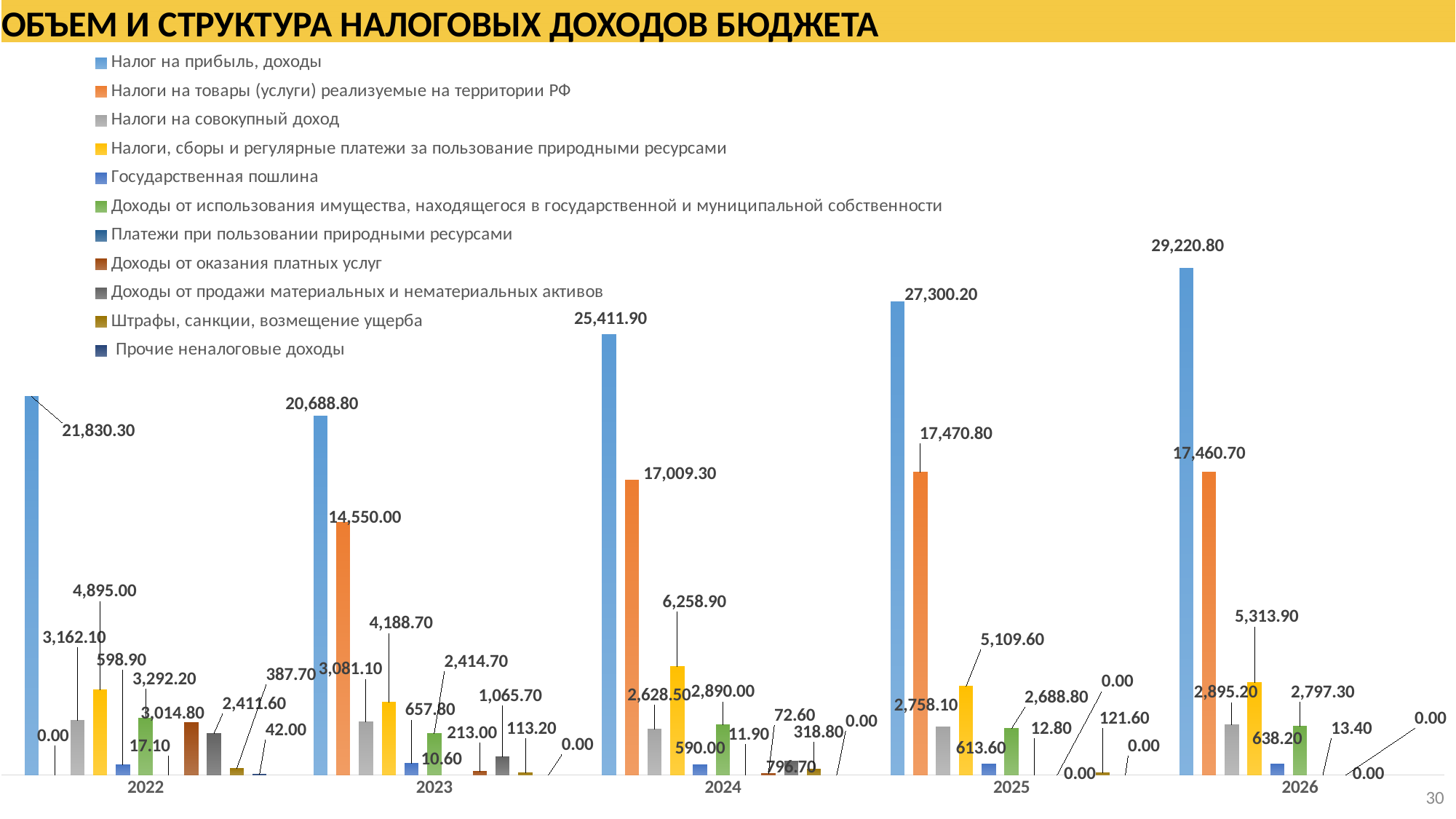
What is the difference between the 'Налог на прибыль, доходы' values for 2026 and 2025? 1,920.60 What is the value of 'Налог на прибыль, доходы' for 2024? 25,411.90 How many years are shown on the x axis? 5 Which is larger: 'Налоги на товары (услуги) реализуемые на территории РФ' in 2025 or in 2024? 2025 What is the title of the chart? ОБЪЕМ И СТРУКТУРА НАЛОГОВЫХ ДОХОДОВ БЮДЖЕТА Does 'Налог на прибыль, доходы' rise or fall from 2023 to 2026? rise What kind of chart is shown on the slide? bar chart How many series does the legend list? 11 What is the value of 'Налоги, сборы и регулярные платежи за пользование природными ресурсами' for 2024? 6,258.90 In which year is 'Налог на прибыль, доходы' lowest? 2023 In which year is 'Налог на прибыль, доходы' highest? 2026 What is the value of 'Налоги на товары (услуги) реализуемые на территории РФ' for 2023? 14,550.00